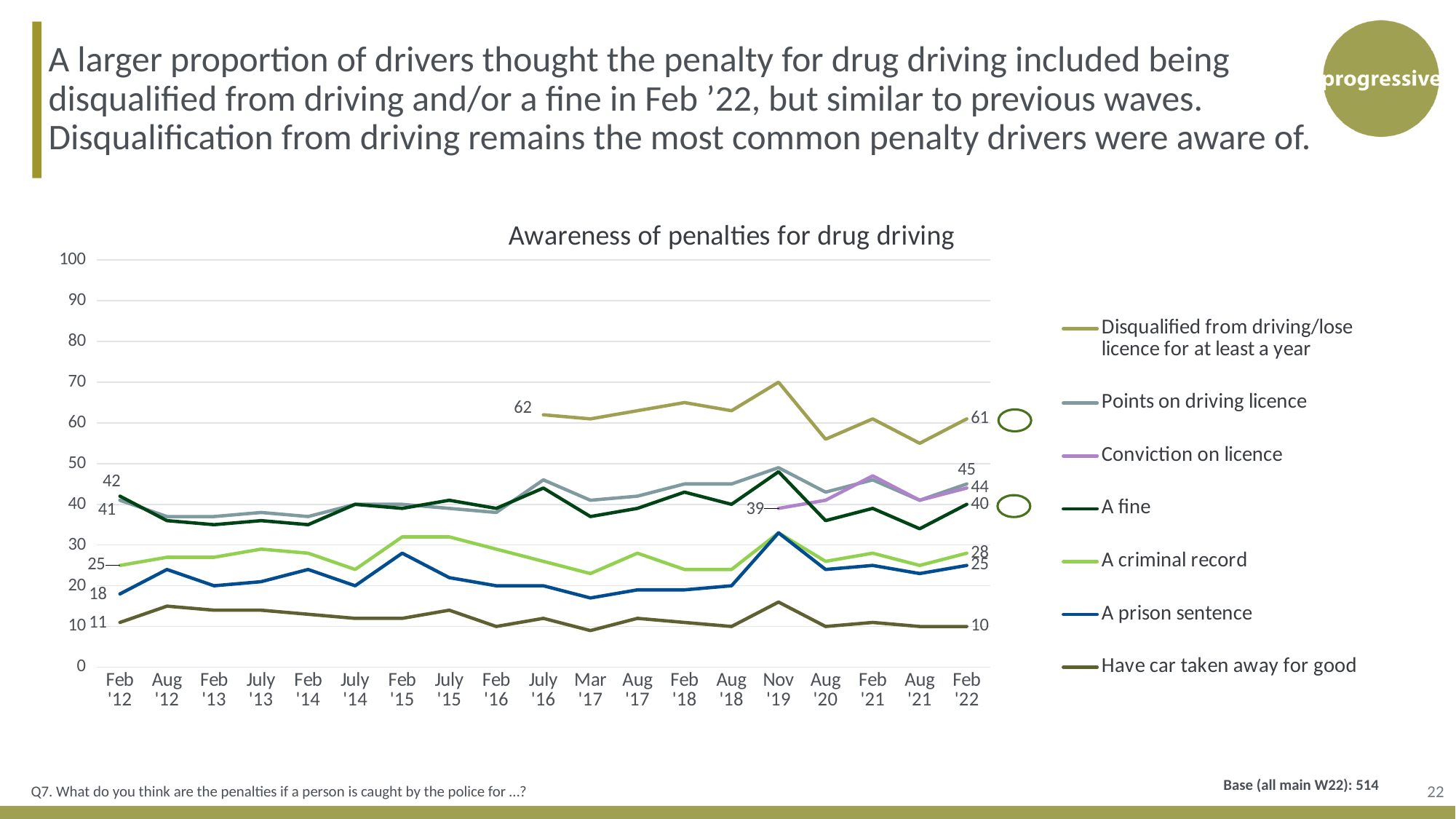
Which series has the highest value in Feb '22? Disqualified from driving/lose licence for at least a year What kind of chart is shown on the slide? Line chart What is the value for 'Disqualified from driving/lose licence for at least a year' in July '16? 62 Is the value for 'Disqualified from driving/lose licence for at least a year' in Nov '19 greater or less than 60? greater How many series does the legend list? 7 What is the value for 'Have car taken away for good' in Feb '22? 10 What is the difference between 'Disqualified from driving/lose licence for at least a year' and 'A fine' in Feb '22? 21 What is the value for 'Disqualified from driving/lose licence for at least a year' in Feb '22? 61 What is the value for 'A fine' in Feb '22? 40 What is the value for 'A prison sentence' in Feb '12? 18 What is the value for 'Conviction on licence' in Nov '19? 39 Which series has the lowest value in Feb '22? Have car taken away for good